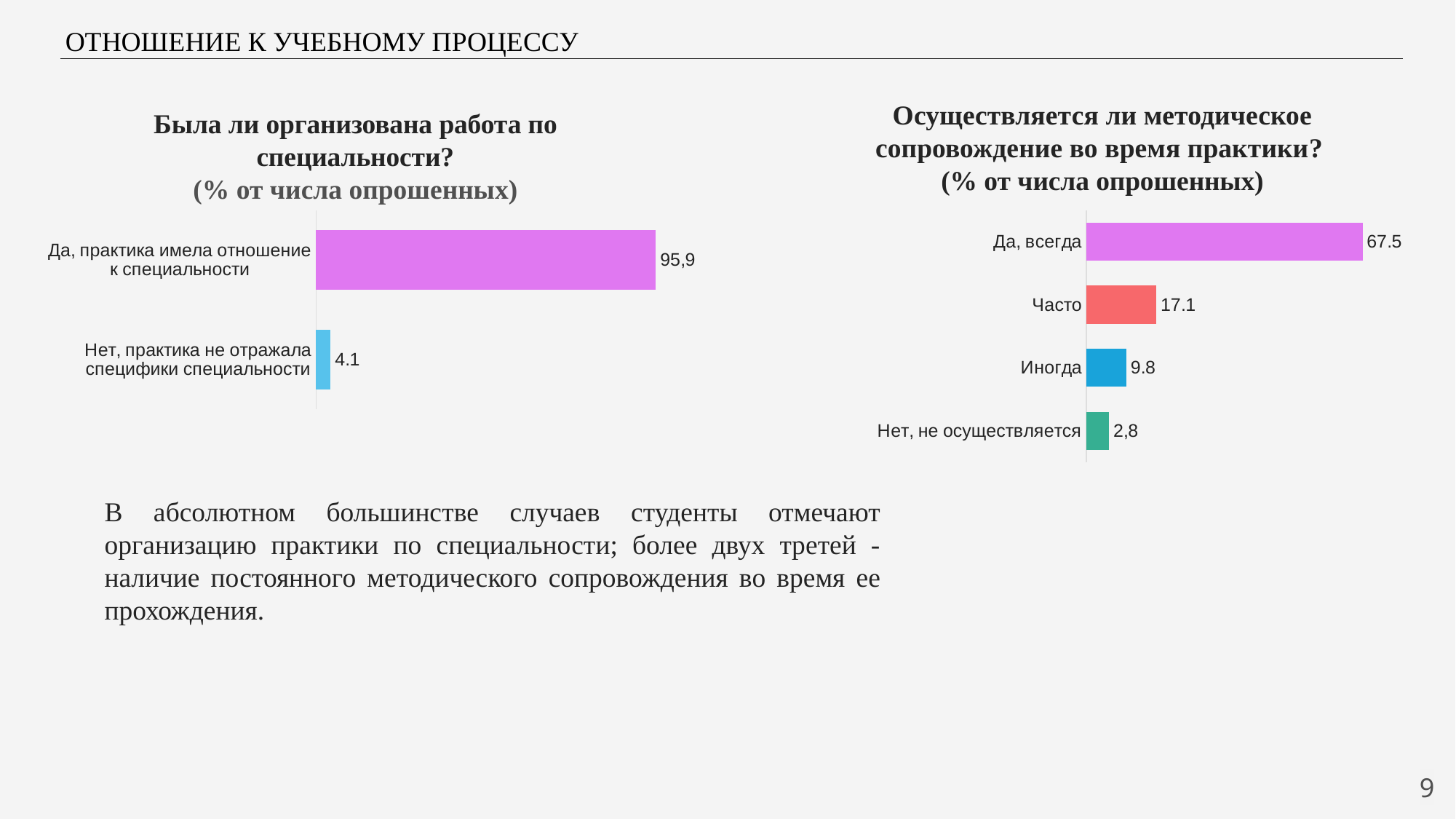
In the right chart 'Осуществляется ли методическое сопровождение во время практики?', what is the value for 'Нет, не осуществляется'? 2,8 What type of chart is the left chart 'Была ли организована работа по специальности?'? bar chart In the right chart 'Осуществляется ли методическое сопровождение во время практики?', which category has the lowest value? Нет, не осуществляется In the left chart 'Была ли организована работа по специальности?', how many categories are shown? 2 In the right chart 'Осуществляется ли методическое сопровождение во время практики?', what is the difference between 'Да, всегда' and 'Часто'? 50.4 In the right chart 'Осуществляется ли методическое сопровождение во время практики?', how many categories are shown? 4 In the left chart 'Была ли организована работа по специальности?', what is the value for 'Нет, практика не отражала специфики специальности'? 4.1 In the right chart 'Осуществляется ли методическое сопровождение во время практики?', what is the value for 'Иногда'? 9.8 In the left chart 'Была ли организована работа по специальности?', what is the value for 'Да, практика имела отношение к специальности'? 95,9 In the right chart 'Осуществляется ли методическое сопровождение во время практики?', which category has the highest value? Да, всегда In the right chart 'Осуществляется ли методическое сопровождение во время практики?', what is the value for 'Да, всегда'? 67.5 In the right chart 'Осуществляется ли методическое сопровождение во время практики?', which is larger: 'Часто' or 'Иногда'? Часто